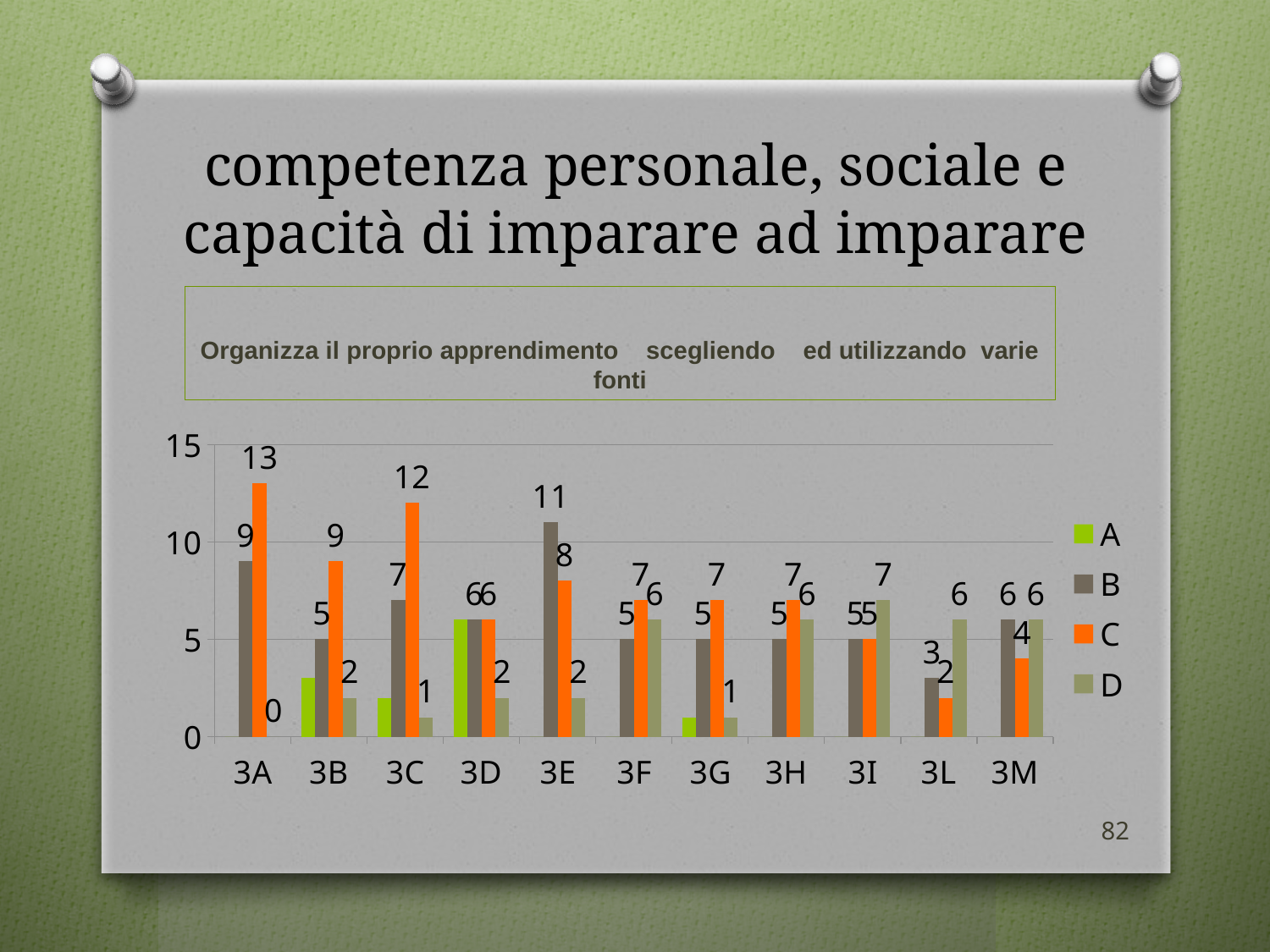
For class 3E, which is larger: series B or series C? B Which class has the highest value for series C? 3A What is the value of series C for class 3A? 13 How many classes are shown on the x axis? 11 Which class has the lowest value for series C? 3L What is the value of series C for class 3C? 12 What is the value of series D for class 3A? 0 What kind of chart is shown on the slide? bar chart What is the difference between series C and series B for class 3A? 4 How many series does the legend list? 4 What is the value of series B for class 3E? 11 Is the value of series A for class 3B greater or less than 5? less